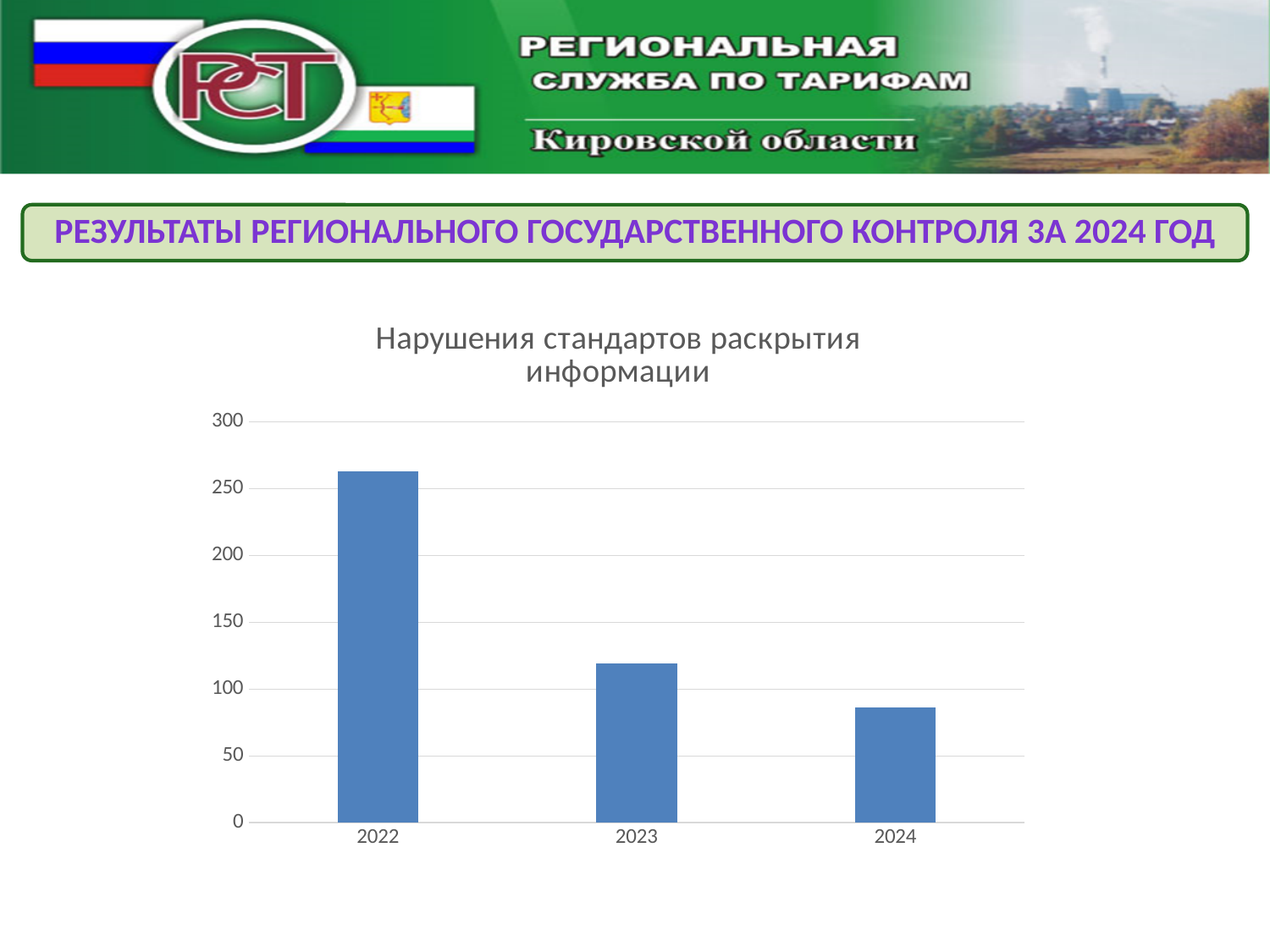
Is the value for 2022 greater or less than 250? greater Which year has the highest number of violations? 2022 Which year has the lowest number of violations? 2024 Is the value for 2024 greater or less than 100? less Do the values rise or fall from 2022 to 2024? fall Is the value for 2023 greater or less than 100? greater Which year has the larger value, 2023 or 2024? 2023 What is the title of the chart? Нарушения стандартов раскрытия информации What kind of chart is shown on the slide? bar chart How many categories (years) are plotted on the chart? 3 What is the highest value shown on the vertical axis? 300